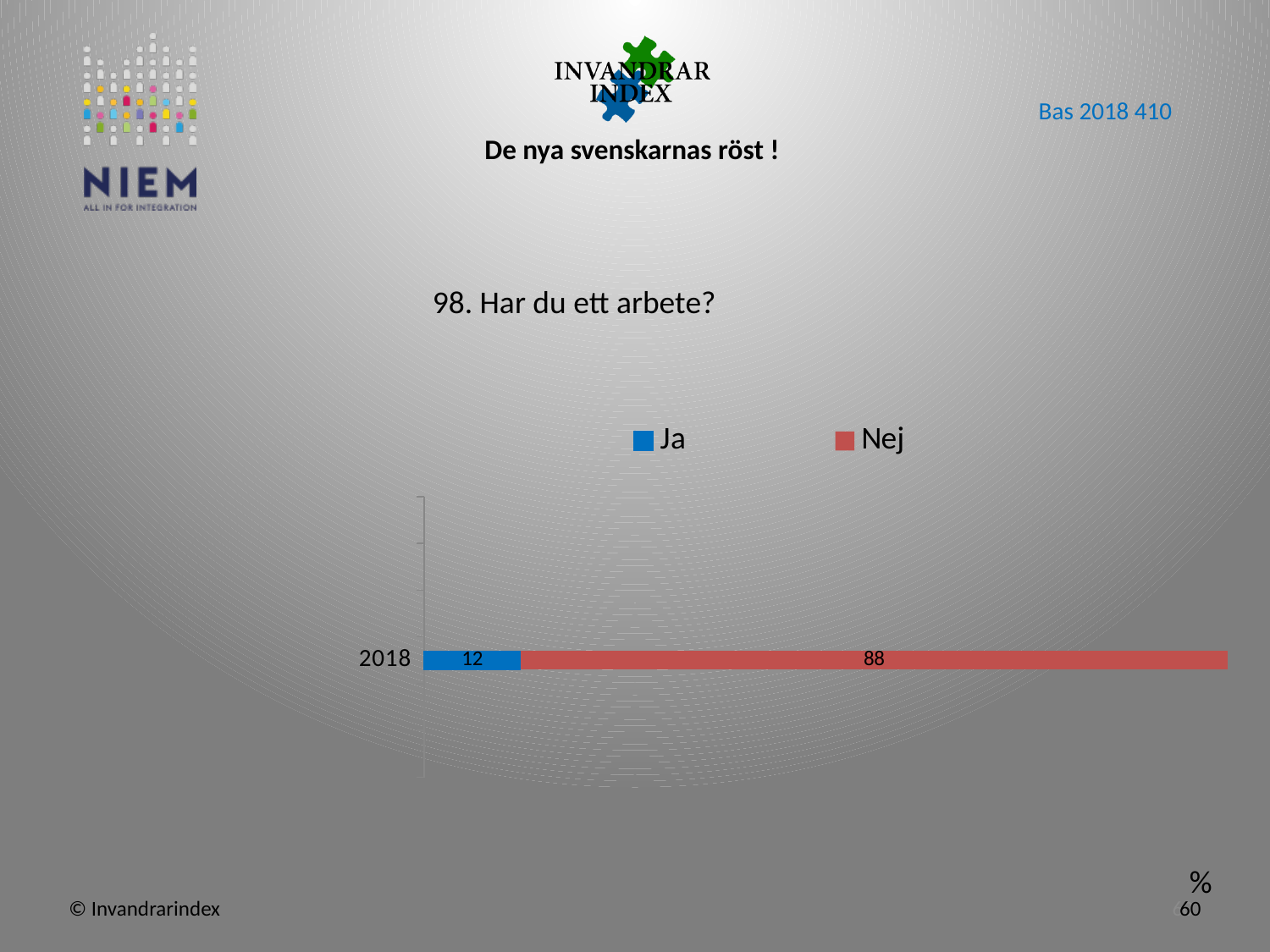
What kind of chart is shown on the slide? Stacked bar chart What is the value for Ja in 2018? 12 Which series has the larger value in 2018, Ja or Nej? Nej What is the title of the chart? 98. Har du ett arbete? How many series does the legend list? 2 What is the value for Nej in 2018? 88 Which colour represents Nej in the chart? Red What is the difference between the Nej and Ja values in 2018? 76 What is the total of the stacked bar for 2018? 100 Which category label is shown on the chart's axis? 2018 How many categories are shown on the chart? 1